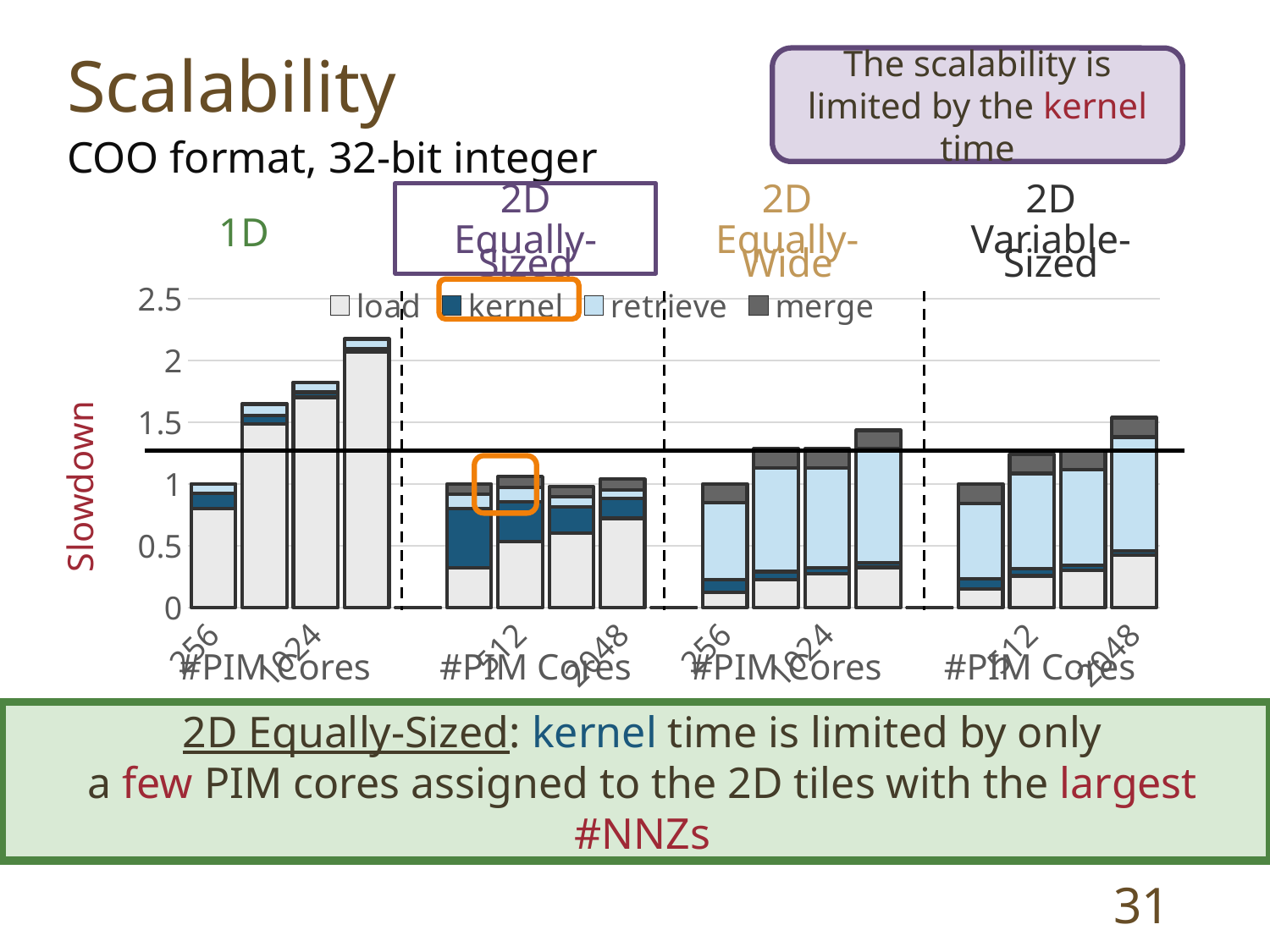
Which number of PIM cores has the highest slowdown in the 1D group? 2048 What is the label on the y axis of the chart? Slowdown What are the four series named in the chart legend? load, kernel, retrieve, merge Is the slowdown for 2048 PIM cores in the 2D Equally-Wide group greater or less than 1? greater How many bars are plotted in the 1D group of the chart? 4 Which is larger: the slowdown for 2048 PIM cores in the 1D group or in the 2D Equally-Sized group? 1D What kind of chart is shown on the slide? stacked bar chart Is the slowdown for 256 PIM cores in the 2D Variable-Sized group greater or less than 1.5? less Is the slowdown for 2048 PIM cores in the 1D group greater or less than 2? greater In the 1D group, does the slowdown rise or fall as the number of PIM cores increases? rises How many series does the chart legend list? 4